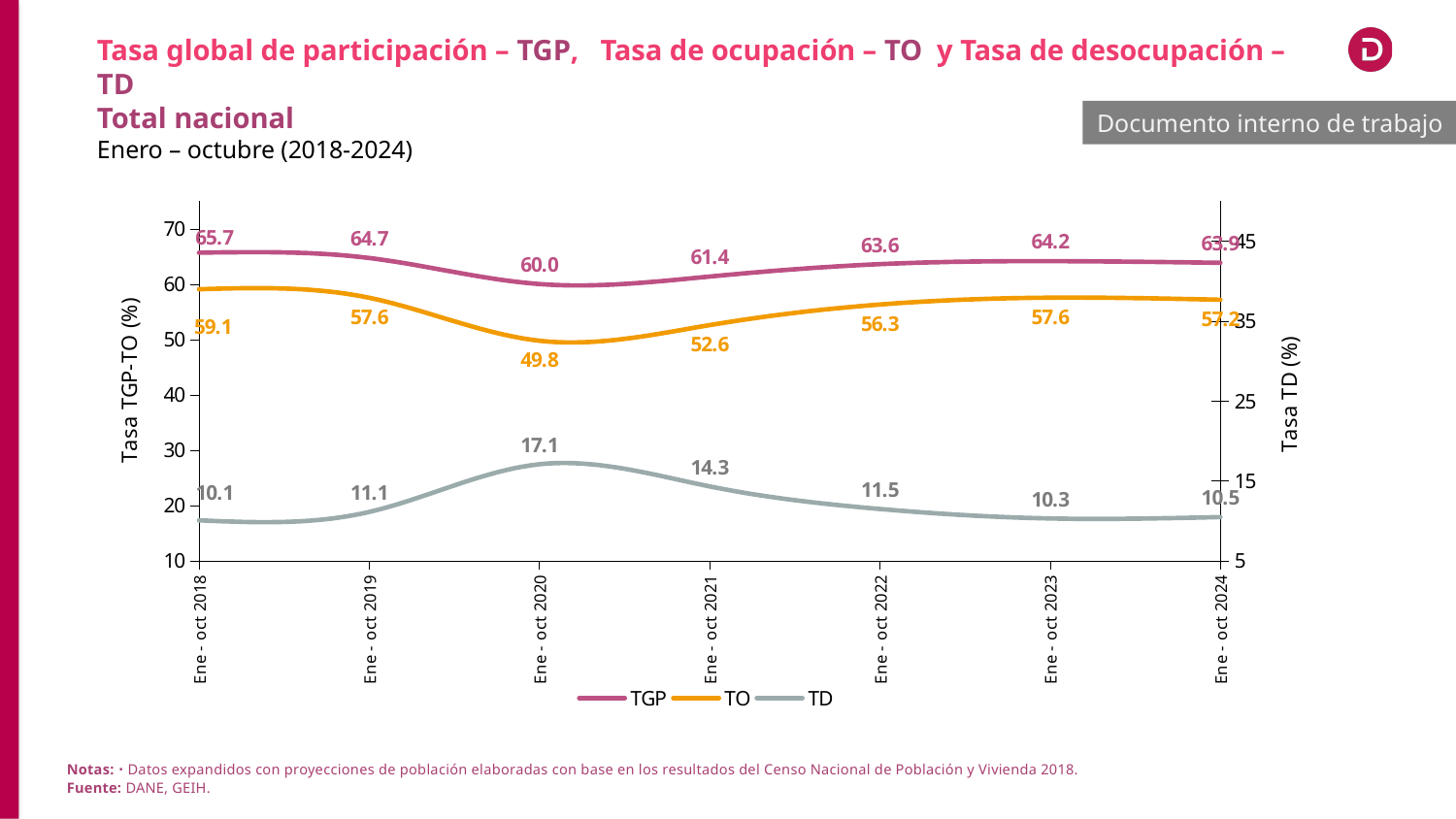
What is the TGP value for Ene - oct 2020? 60.0 In which period is the TO series lowest? Ene - oct 2020 How many series does the legend list? 3 How many periods are shown on the x axis? 7 What is the TO value for Ene - oct 2021? 52.6 What is the TD value for Ene - oct 2023? 10.3 What type of chart is shown on the slide? line chart Does the TD series rise or fall from Ene - oct 2020 to Ene - oct 2023? fall What is the difference between the TGP value for Ene - oct 2018 and Ene - oct 2020? 5.7 What is the label of the right-hand vertical axis? Tasa TD (%) Which is larger, the TO value for Ene - oct 2019 or for Ene - oct 2022? Ene - oct 2019 In which period is the TD series highest? Ene - oct 2020